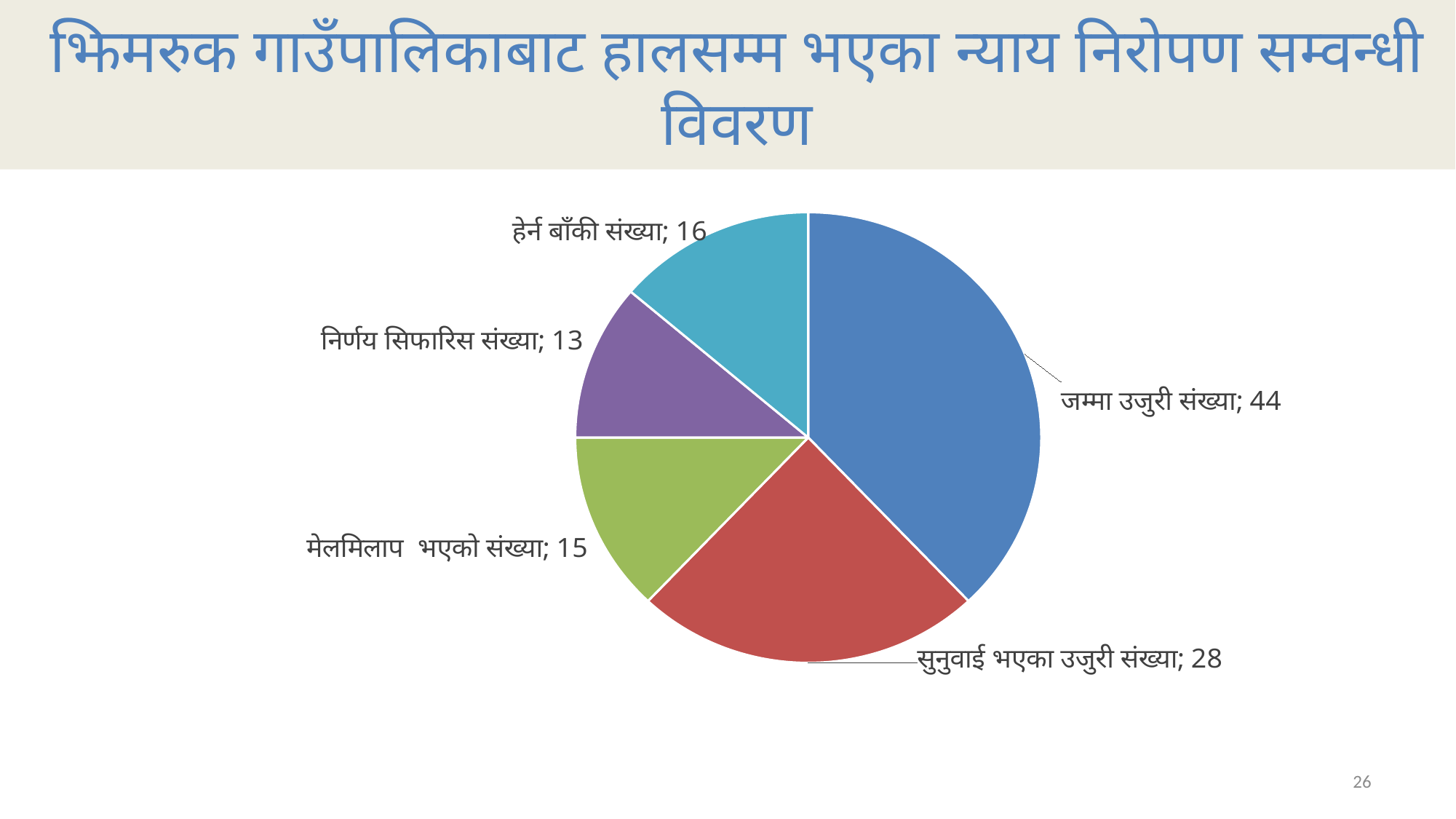
What colour is the slice for सुनुवाई भएका उजुरी संख्या? Red Which category has the largest slice in the pie chart? जम्मा उजुरी संख्या Which is larger, हेर्न बाँकी संख्या or मेलमिलाप भएको संख्या? हेर्न बाँकी संख्या What is the value for हेर्न बाँकी संख्या? 16 What is the value for जम्मा उजुरी संख्या? 44 What is the value for सुनुवाई भएका उजुरी संख्या? 28 What kind of chart is shown on the slide? Pie chart Which category has the smallest slice in the pie chart? निर्णय सिफारिस संख्या What is the value for मेलमिलाप भएको संख्या? 15 What is the difference between जम्मा उजुरी संख्या and सुनुवाई भएका उजुरी संख्या? 16 What is the value for निर्णय सिफारिस संख्या? 13 How many slices does the pie chart have? 5